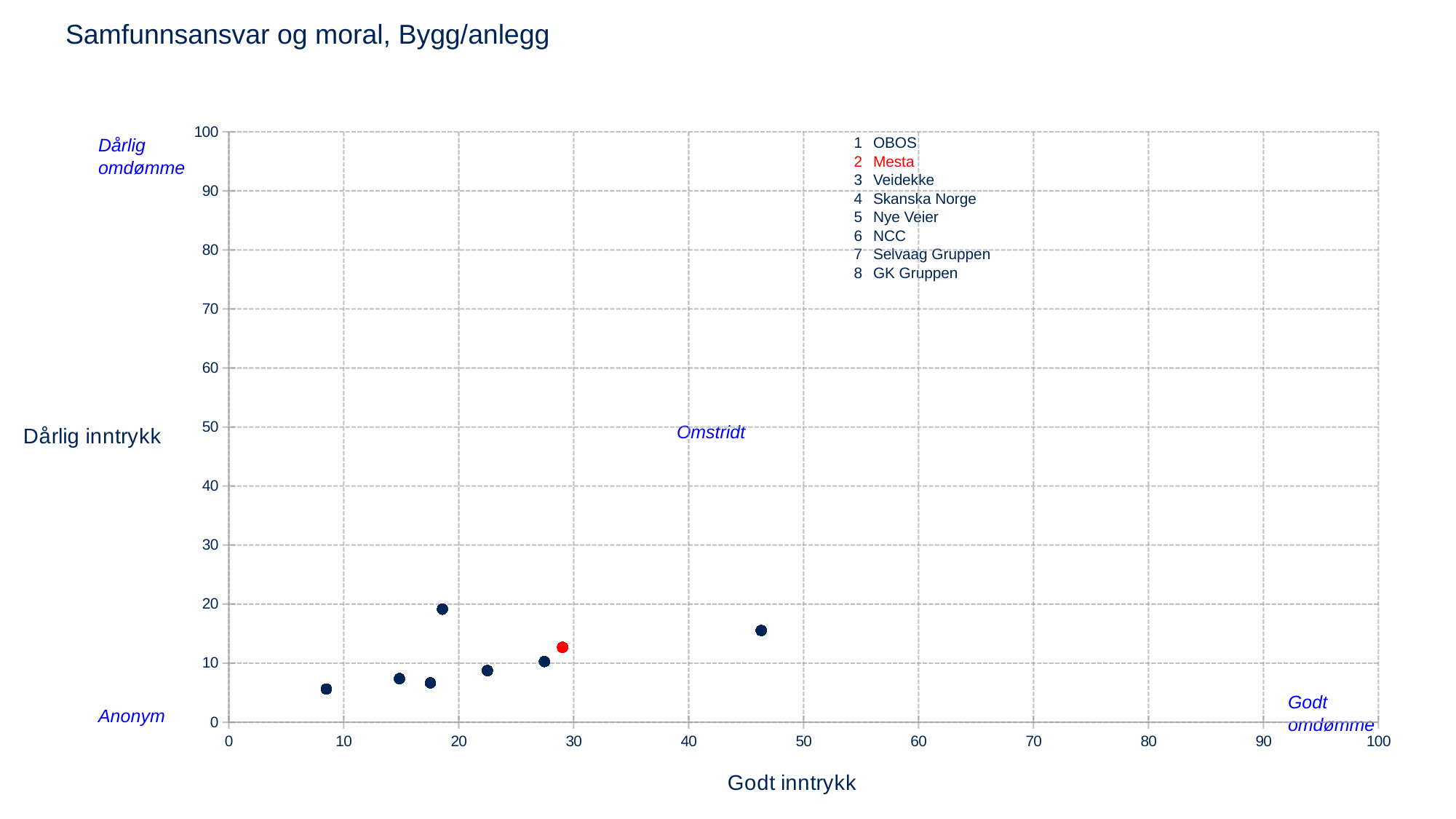
What is the title of the chart? Samfunnsansvar og moral, Bygg/anlegg Is the y-axis value for the red point (Mesta) greater or less than 20? less What kind of chart is shown on the slide? scatter chart What is the label of the x axis? Godt inntrykk Is the x-axis value of the rightmost point greater or less than 40? greater How many data points are plotted on the chart? 8 Which company in the legend is highlighted in red? Mesta How many companies does the legend list? 8 How many points have an x-axis value greater than 40? 1 Is the y-axis value of the highest point greater or less than 30? less